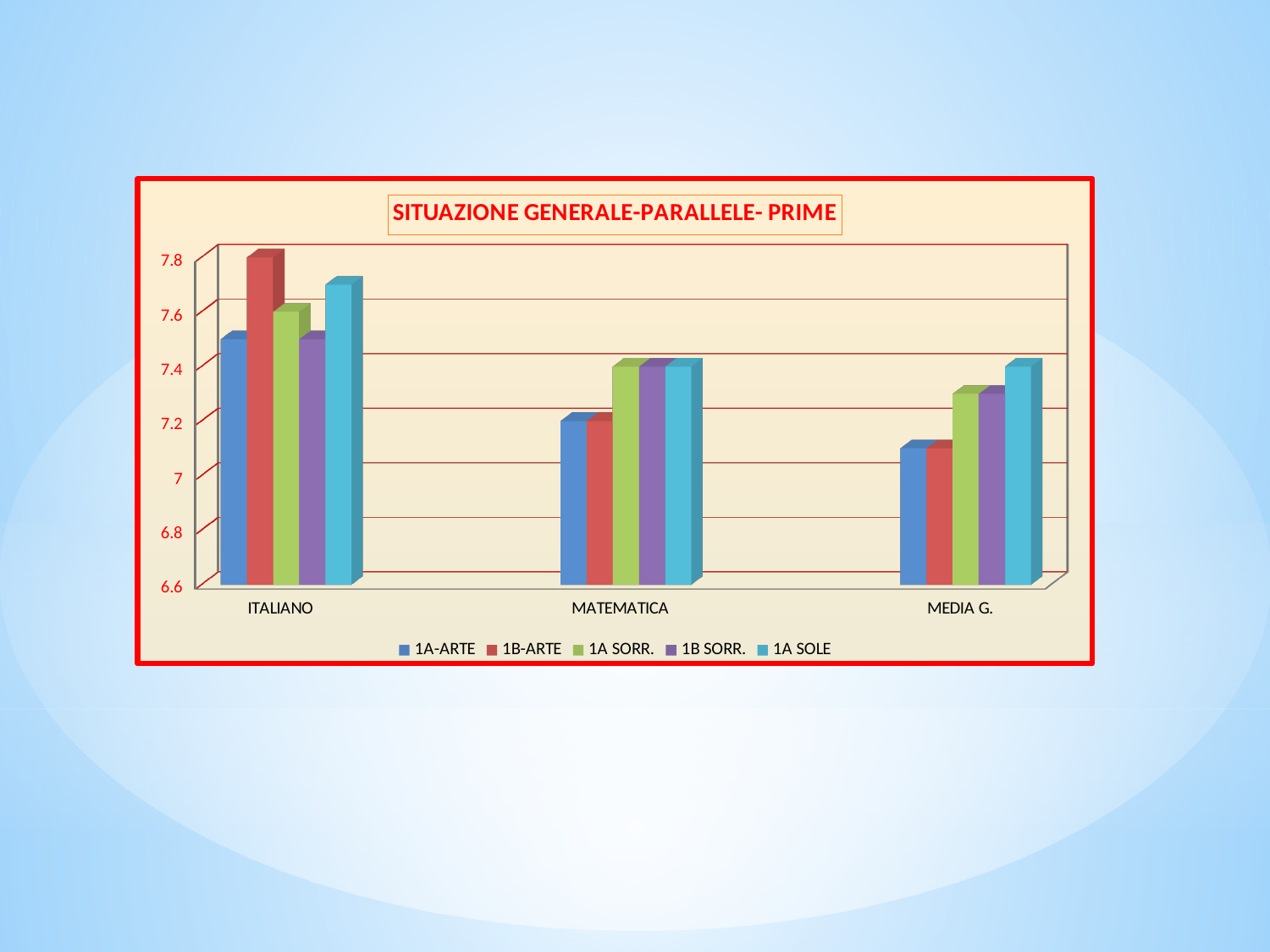
How many categories are shown on the x axis of the chart? 3 For the 1B-ARTE series, which is larger: the value for ITALIANO or the value for MATEMATICA? ITALIANO Which series has the highest value for MEDIA G.? 1A SOLE What is the title of the chart? SITUAZIONE GENERALE-PARALLELE- PRIME What kind of chart is shown on the slide? bar chart Is the value of 1A-ARTE for MEDIA G. greater or less than 7.2? less How many series does the chart's legend list? 5 For MATEMATICA, which is larger: the value of 1A SORR. or the value of 1A-ARTE? 1A SORR. What is the value of 1B-ARTE for ITALIANO? 7.8 Is the value of 1A SOLE for ITALIANO greater or less than 7.6? greater What is the value of 1A-ARTE for MATEMATICA? 7.2 Which series has the highest value for ITALIANO? 1B-ARTE